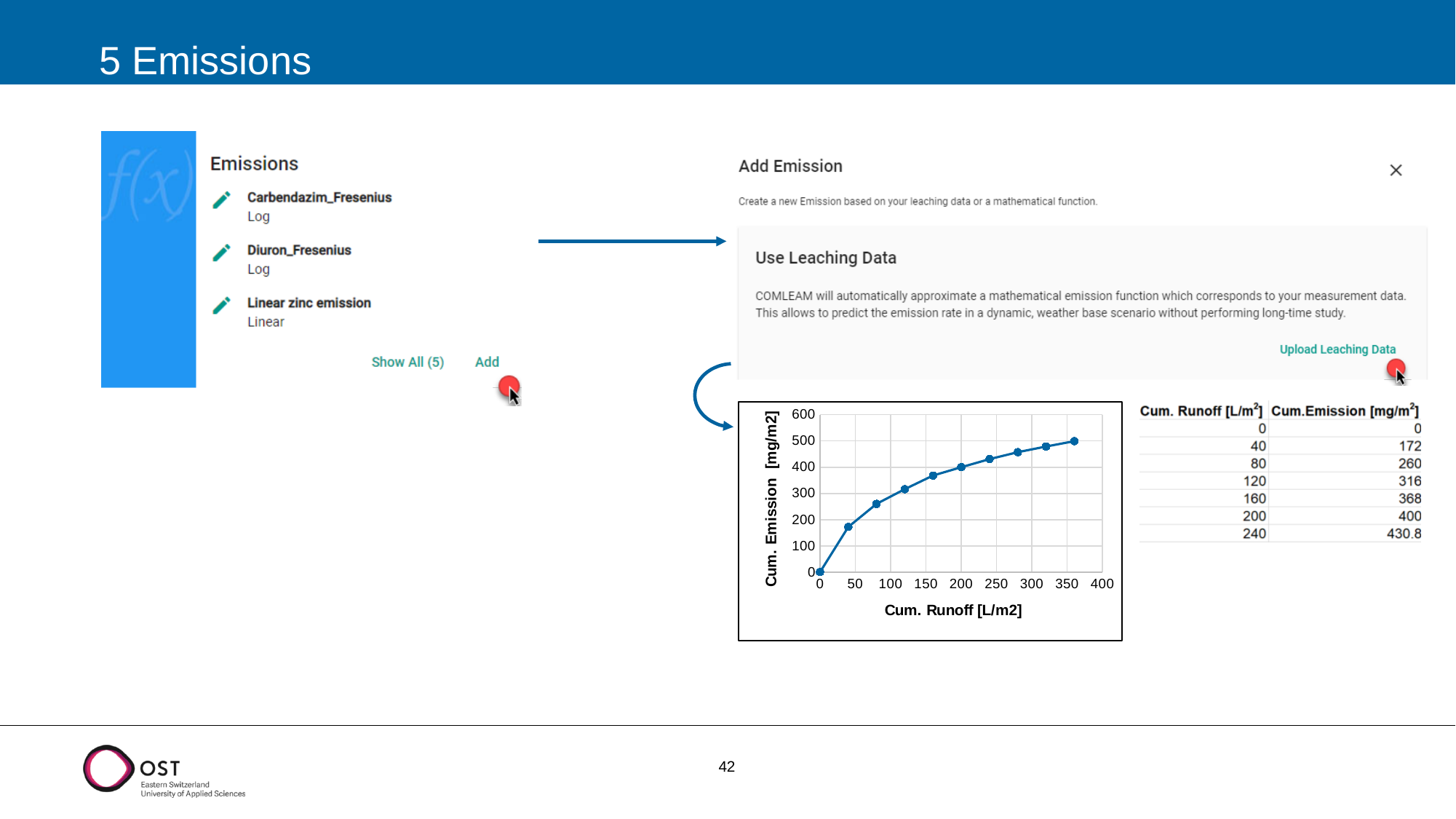
What is the label of the y axis of the chart? Cum. Emission [mg/m2] Is the Cum. Emission value at a Cum. Runoff of 120 greater or less than 300? greater What is the Cum. Emission value at a Cum. Runoff of 0 L/m2? 0 Which has the larger Cum. Emission value: a Cum. Runoff of 80 or of 240? 240 What is the label of the x axis of the chart? Cum. Runoff [L/m2] How many data points are plotted on the line chart? 10 Is the Cum. Emission value at a Cum. Runoff of 360 greater or less than 400? greater Is the Cum. Emission value at a Cum. Runoff of 40 greater or less than 200? less What is the Cum. Emission value at a Cum. Runoff of 200 L/m2? 400 At which Cum. Runoff value is the Cum. Emission highest? 360 What kind of chart is shown on the slide? line chart Do the values on the line chart rise or fall as Cum. Runoff increases? rise